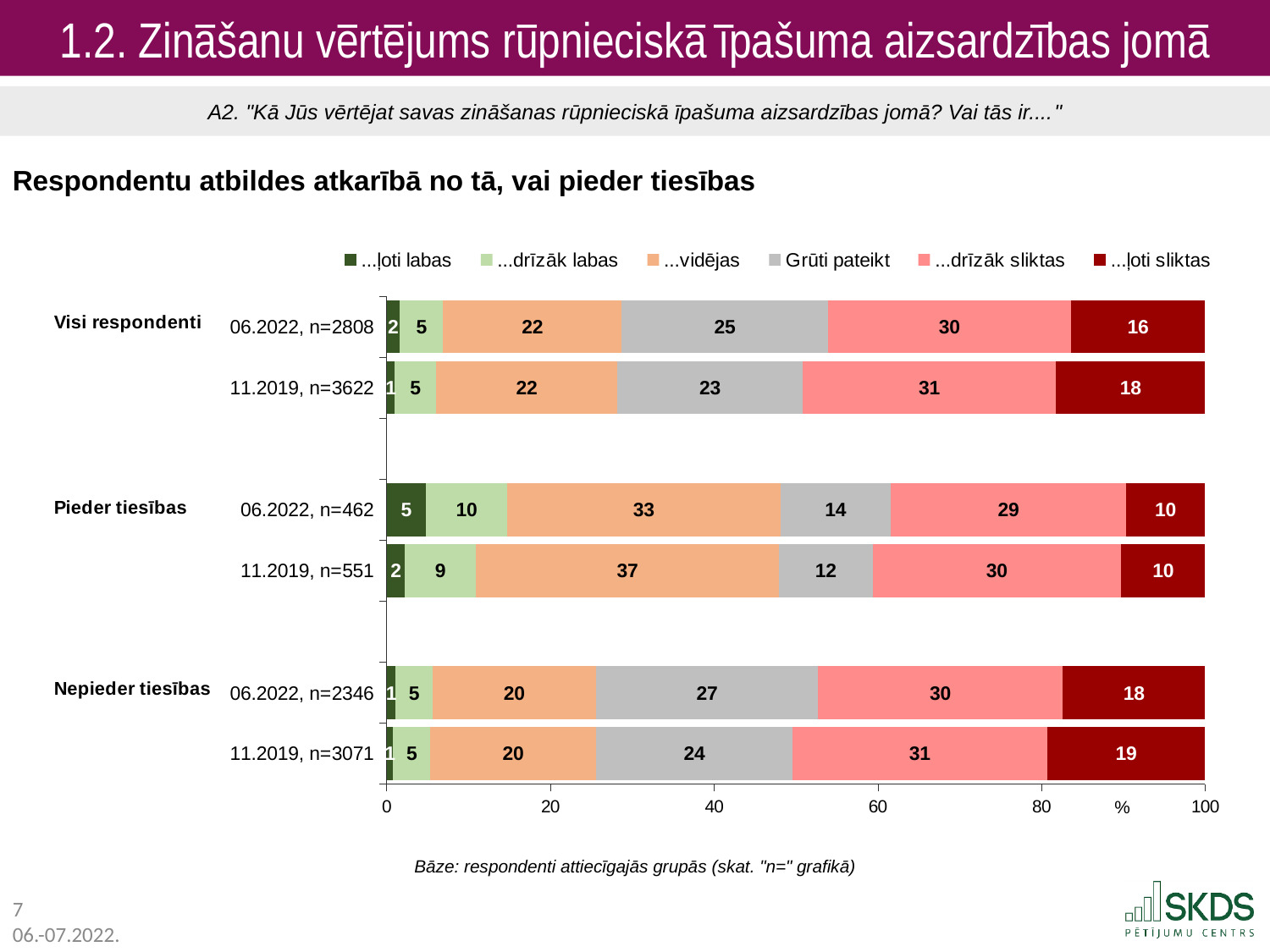
What type of chart is shown on the slide? Stacked bar chart What is the value of "...ļoti labas" for Pieder tiesības, 06.2022, n=462? 5 What is the value of "Grūti pateikt" for Nepieder tiesības, 06.2022, n=2346? 27 What is the value of "...ļoti sliktas" for Visi respondenti, 06.2022, n=2808? 16 What is the value of "...vidējas" for Pieder tiesības, 11.2019, n=551? 37 How many bars are plotted in the chart? 6 Which is larger: the "...ļoti sliktas" value for Nepieder tiesības, 11.2019, n=3071 or for Pieder tiesības, 06.2022, n=462? Nepieder tiesības, 11.2019, n=3071 What is the last entry in the chart legend? ...ļoti sliktas Which bar has the lowest value for "Grūti pateikt"? Pieder tiesības, 11.2019, n=551 What is the difference between the "...drīzāk sliktas" value for Visi respondenti, 11.2019, n=3622 and for Pieder tiesības, 06.2022, n=462? 2 Which bar has the highest value for "...vidējas"? Pieder tiesības, 11.2019, n=551 How many series does the legend list? 6